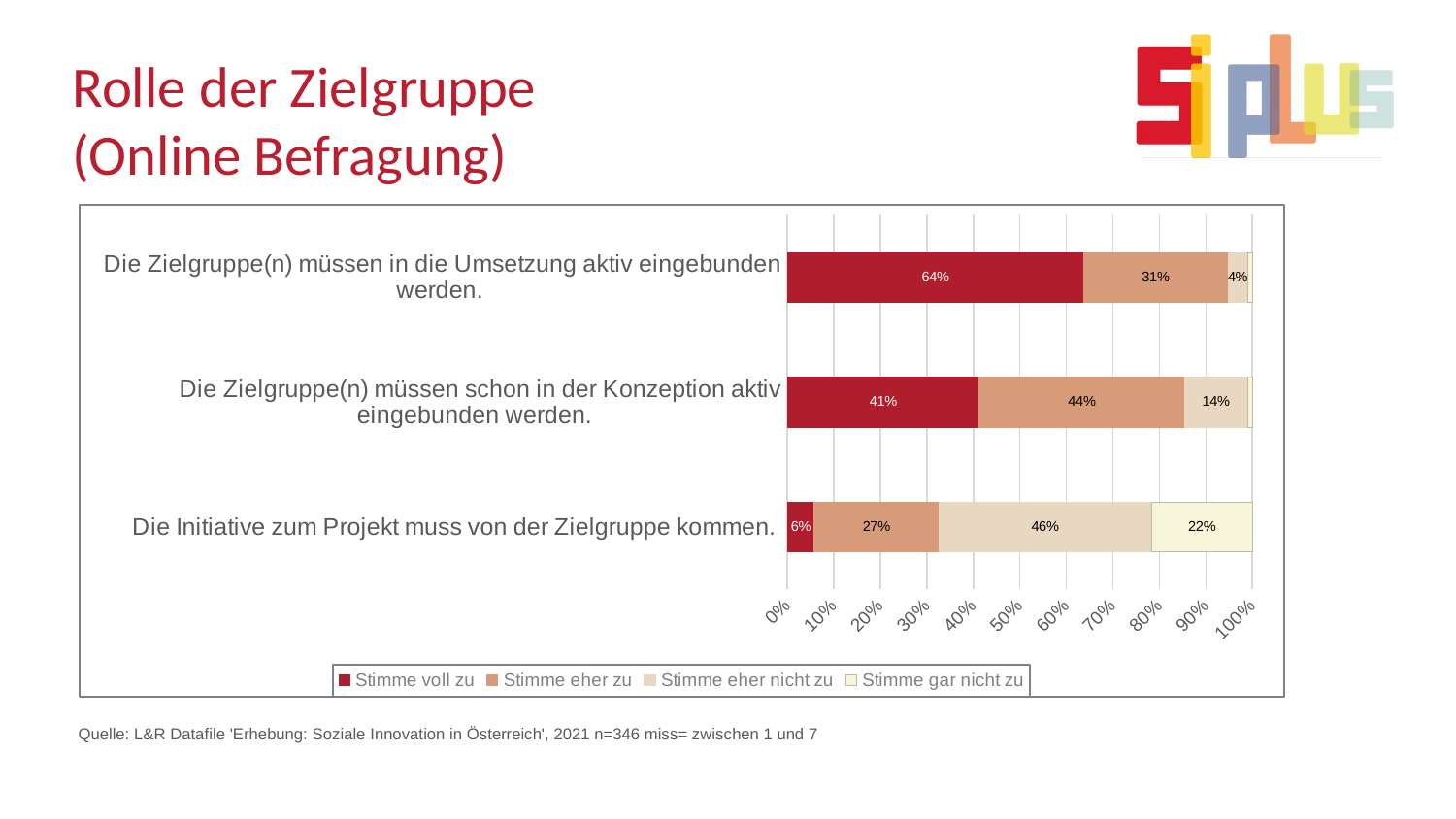
How many statements are shown in the chart? 3 What type of chart is shown on the slide? Stacked bar chart What percentage of respondents answered "Stimme voll zu" to "Die Zielgruppe(n) müssen in die Umsetzung aktiv eingebunden werden."? 64% Which legend entry is shown in dark red? Stimme voll zu What is the "Stimme eher zu" value for "Die Zielgruppe(n) müssen schon in der Konzeption aktiv eingebunden werden."? 44% Which statement has the highest "Stimme voll zu" share? Die Zielgruppe(n) müssen in die Umsetzung aktiv eingebunden werden. By how many percentage points does the "Stimme voll zu" share for the Umsetzung statement exceed that for the Konzeption statement? 23 percentage points Which statement has the larger "Stimme eher zu" share: the Umsetzung statement or the Konzeption statement? Die Zielgruppe(n) müssen schon in der Konzeption aktiv eingebunden werden. What share of respondents chose "Stimme gar nicht zu" for "Die Initiative zum Projekt muss von der Zielgruppe kommen."? 22% How many response categories does the legend list? 4 What is the "Stimme eher nicht zu" value for "Die Zielgruppe(n) müssen in die Umsetzung aktiv eingebunden werden."? 4% Which statement has the lowest "Stimme voll zu" share? Die Initiative zum Projekt muss von der Zielgruppe kommen.